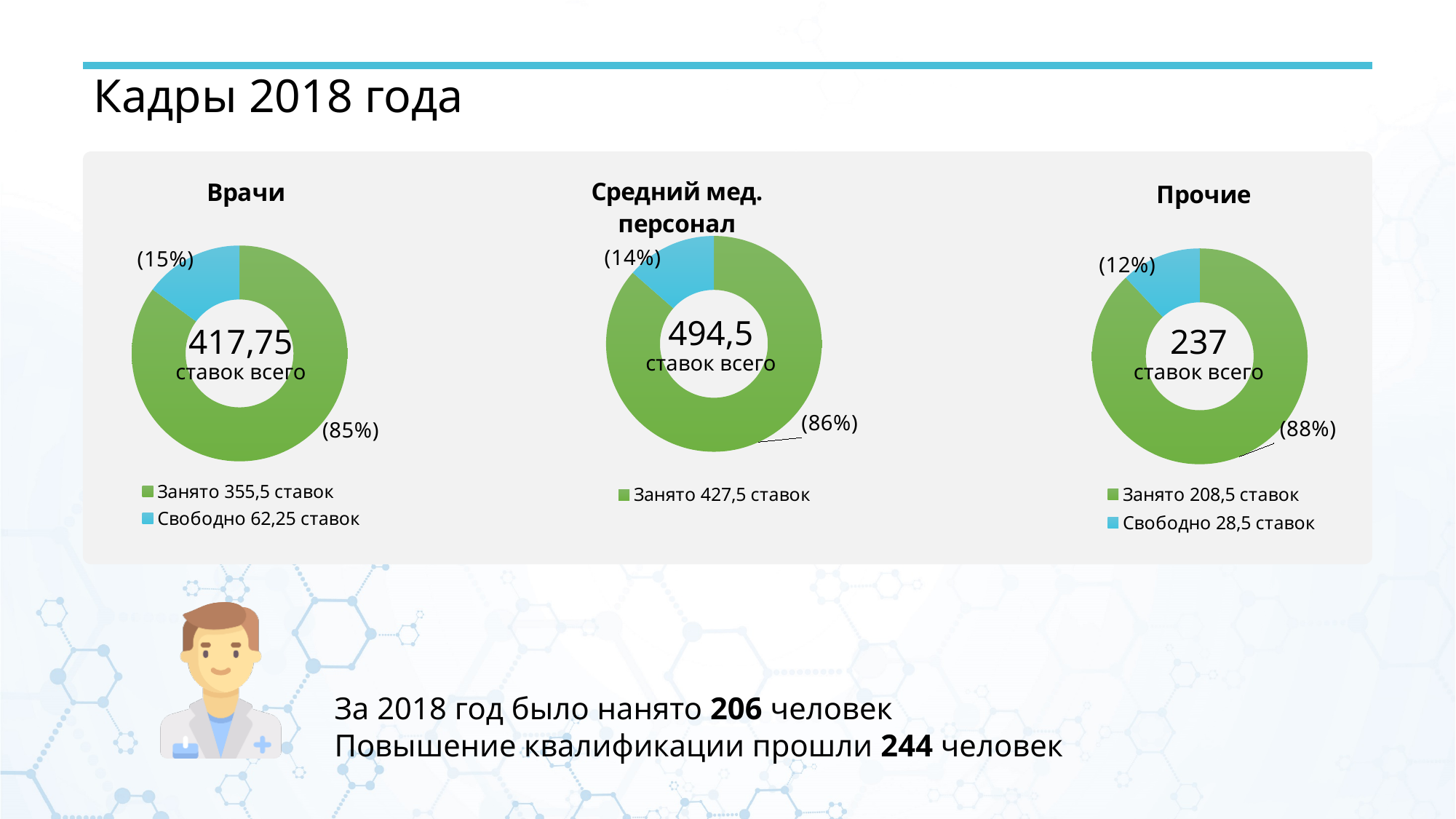
In the "Прочие" chart, what share of positions is occupied? 88% Which of the three charts has the largest total number of positions? Средний мед. персонал In the "Средний мед. персонал" chart, what share of positions is occupied? 86% In the "Средний мед. персонал" chart, what is the total number of positions shown in the centre? 494,5 ставок всего How many legend entries does the "Средний мед. персонал" chart list? 1 In the "Прочие" chart, how many positions are vacant (Свободно)? 28,5 ставок In the "Врачи" chart, what is the total number of positions shown in the centre? 417,75 ставок всего In the "Врачи" chart, how many positions are occupied (Занято)? 355,5 ставок In the "Врачи" chart, what share of positions is vacant? 15% In the "Средний мед. персонал" chart, how many positions are occupied (Занято)? 427,5 ставок In the "Врачи" chart, how many positions are vacant (Свободно)? 62,25 ставок What kind of chart is used for the "Врачи" chart? Pie (donut) chart